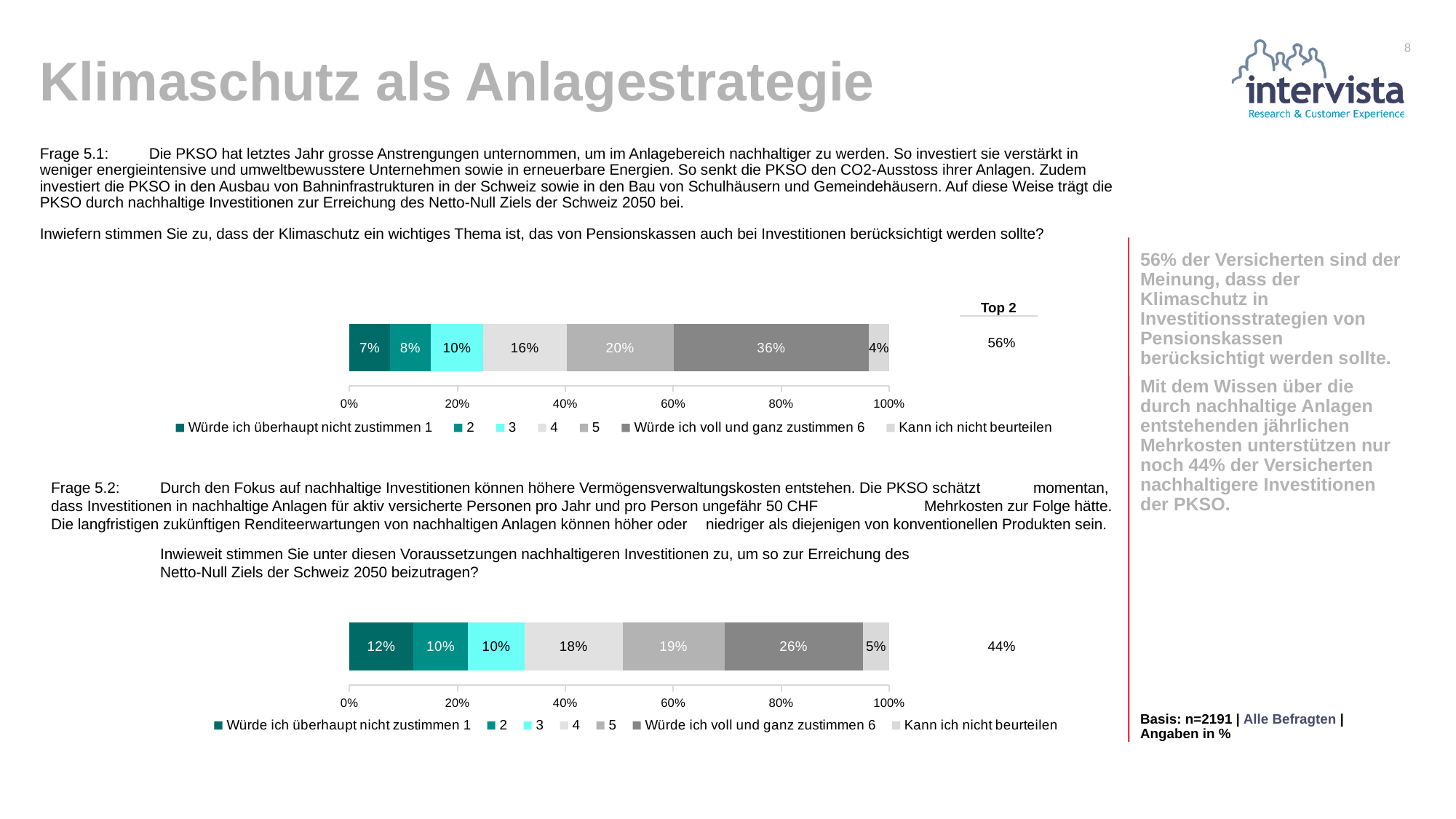
In the bottom chart (Frage 5.2), what percentage chose 'Würde ich voll und ganz zustimmen 6'? 26% What is the Top 2 value shown next to the bottom chart (Frage 5.2)? 44% How many series does the legend of the top chart (Frage 5.1) list? 7 In the top chart (Frage 5.1), what percentage chose 'Würde ich voll und ganz zustimmen 6'? 36% What is the Top 2 value shown next to the top chart (Frage 5.1)? 56% What is the difference between the share for 'Würde ich voll und ganz zustimmen 6' in the top chart (Frage 5.1) and in the bottom chart (Frage 5.2)? 10 percentage points What type of chart is used for Frage 5.1? Stacked bar chart In the top chart (Frage 5.1), what percentage chose 'Würde ich überhaupt nicht zustimmen 1'? 7% In the bottom chart (Frage 5.2), which response category has the smallest share? Kann ich nicht beurteilen In the bottom chart (Frage 5.2), what percentage chose 'Kann ich nicht beurteilen'? 5% In the top chart (Frage 5.1), which response category has the largest share? Würde ich voll und ganz zustimmen 6 Is the share for 'Würde ich überhaupt nicht zustimmen 1' larger in the top chart (Frage 5.1) or in the bottom chart (Frage 5.2)? Bottom chart (Frage 5.2)